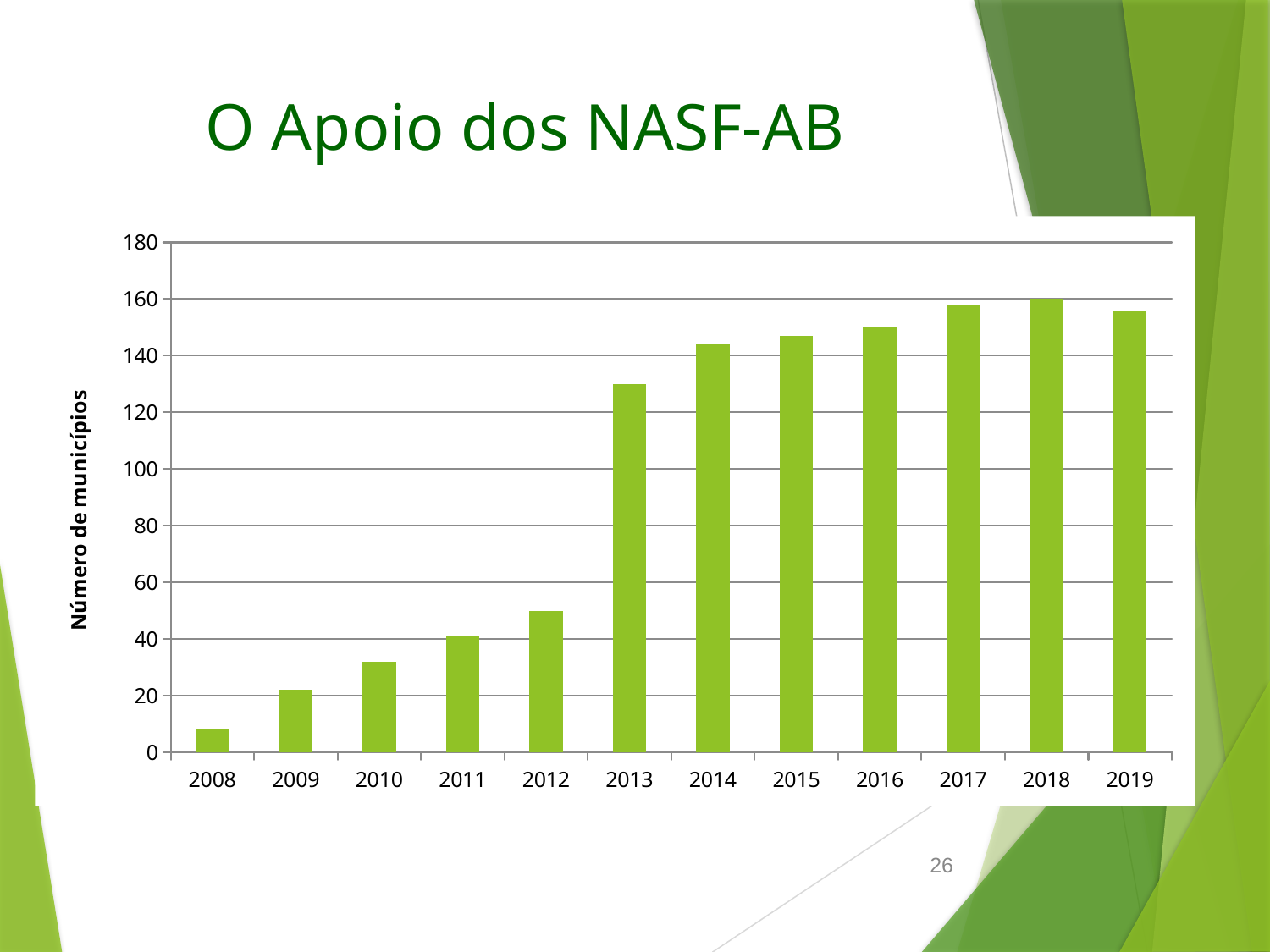
Which year has the larger value, 2008 or 2009? 2009 What kind of chart is shown on the slide? bar chart How many years are shown on the x axis of the chart? 12 Which year has the larger value, 2012 or 2013? 2013 Is the value for 2016 greater or less than 140? greater Which year has the lowest number of municípios? 2008 Is the value for 2011 greater or less than 60? less Is the value for 2013 greater or less than 120? greater What is the label on the vertical axis of the chart? Número de municípios Do the values generally rise or fall from 2008 to 2018? rise